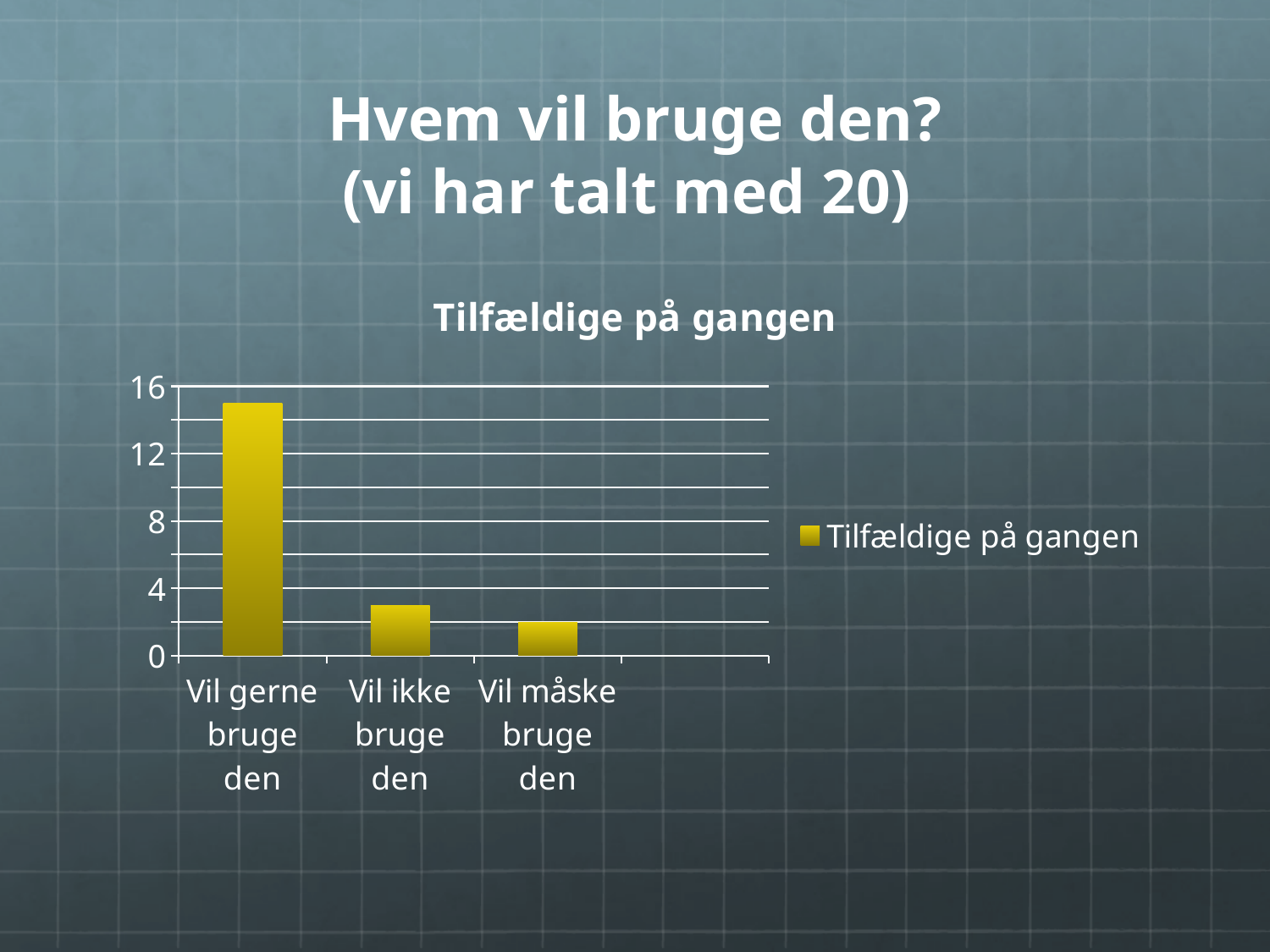
What kind of chart is shown on the slide? bar chart Which category has the highest bar in the chart? Vil gerne bruge den How many series does the chart's legend list? 1 Is the value for Vil gerne bruge den greater or less than 12? greater Is the value for Vil ikke bruge den greater or less than 4? less Which is larger, the value for Vil ikke bruge den or the value for Vil måske bruge den? Vil ikke bruge den How many categories are shown on the x axis of the chart? 3 What is the title of the chart? Tilfældige på gangen What colour are the bars in the chart? yellow Is the value for Vil måske bruge den greater or less than 4? less Which category has the lowest bar in the chart? Vil måske bruge den